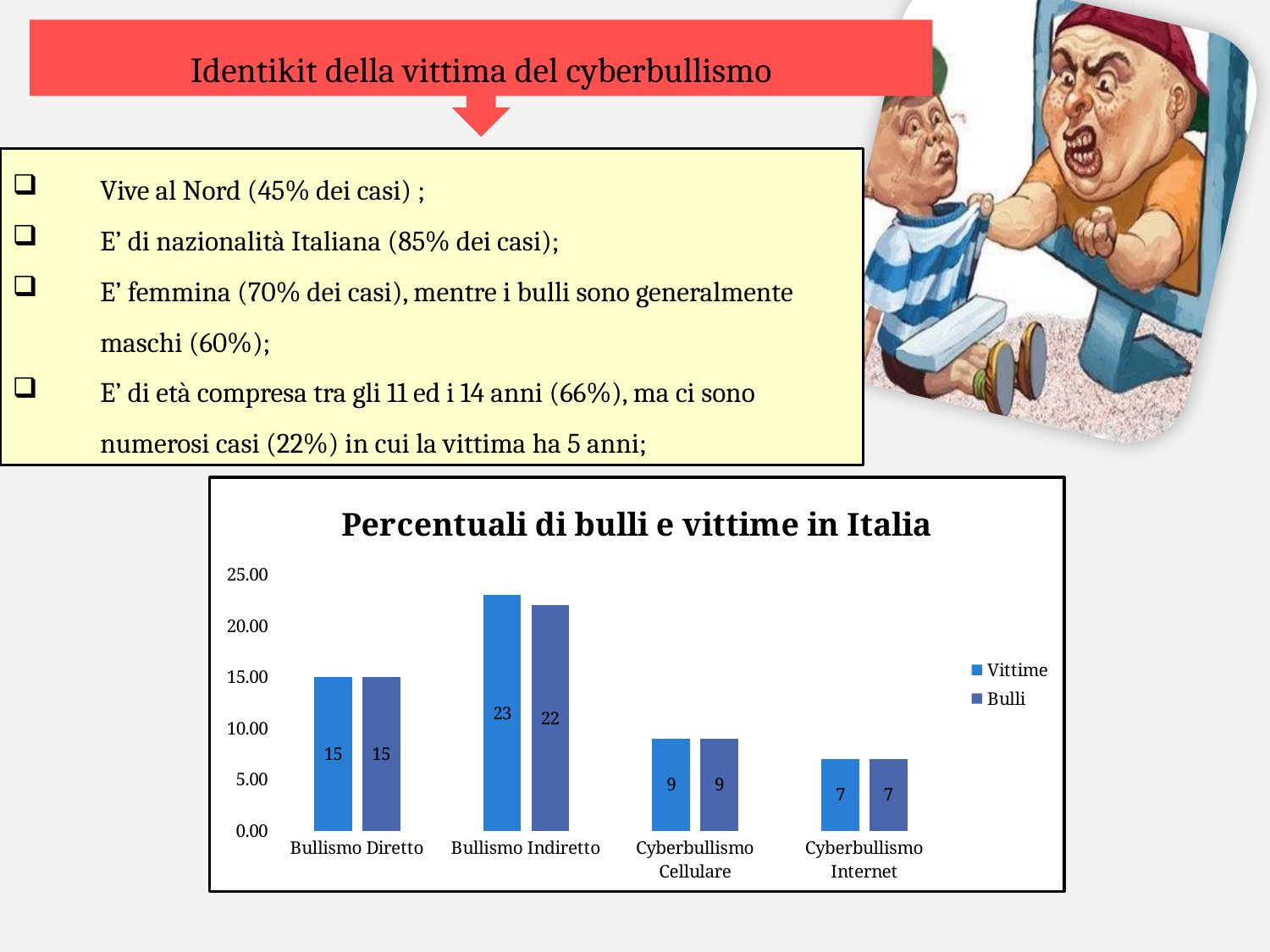
What is the value for Vittime in the Bullismo Indiretto category? 23 What is the value for Bulli in the Bullismo Indiretto category? 22 Which category has the lowest value for Bulli? Cyberbullismo Internet How many categories are shown on the x axis? 4 How many series does the legend list? 2 What is the value for Vittime in the Cyberbullismo Internet category? 7 What is the difference between the Vittime and Bulli values in the Bullismo Indiretto category? 1 What is the title of the chart? Percentuali di bulli e vittime in Italia Which category has the highest value for Vittime? Bullismo Indiretto Is the Vittime value for Bullismo Indiretto greater or less than 20.00? greater What is the value for Bulli in the Cyberbullismo Cellulare category? 9 What is the difference between the Vittime value for Bullismo Diretto and the Vittime value for Cyberbullismo Internet? 8